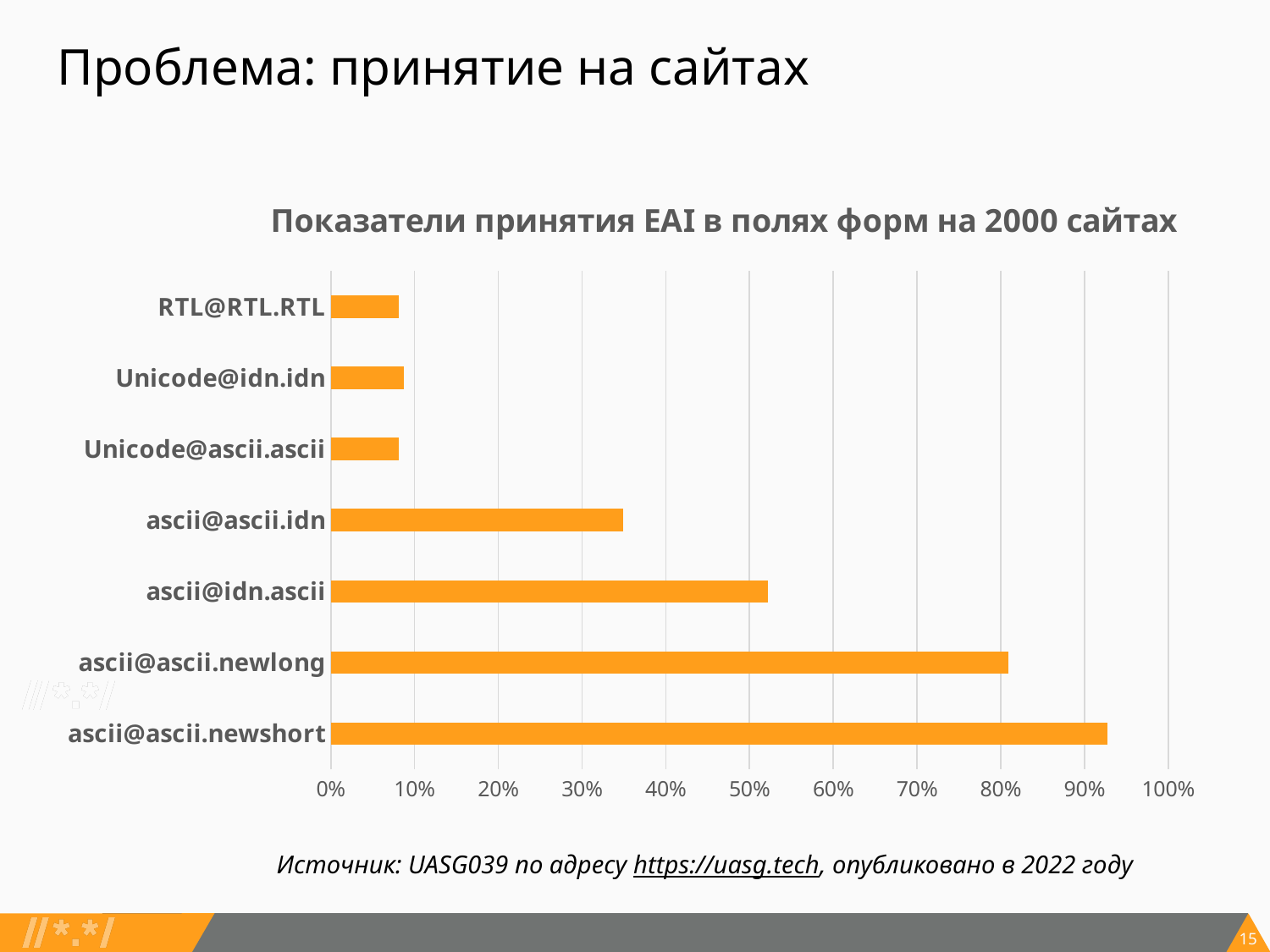
Is the value for ascii@ascii.idn greater or less than 40%? less How many categories are plotted in the chart? 7 Is the value for ascii@idn.ascii greater or less than 50%? greater Which is larger, the value for Unicode@ascii.ascii or the value for ascii@ascii.newlong? ascii@ascii.newlong Which is larger, the value for ascii@idn.ascii or the value for ascii@ascii.idn? ascii@idn.ascii Is the value for Unicode@idn.idn greater or less than 20%? less Which category has the highest value in the chart? ascii@ascii.newshort What is the title of the chart? Показатели принятия EAI в полях форм на 2000 сайтах What kind of chart is shown on the slide? bar chart